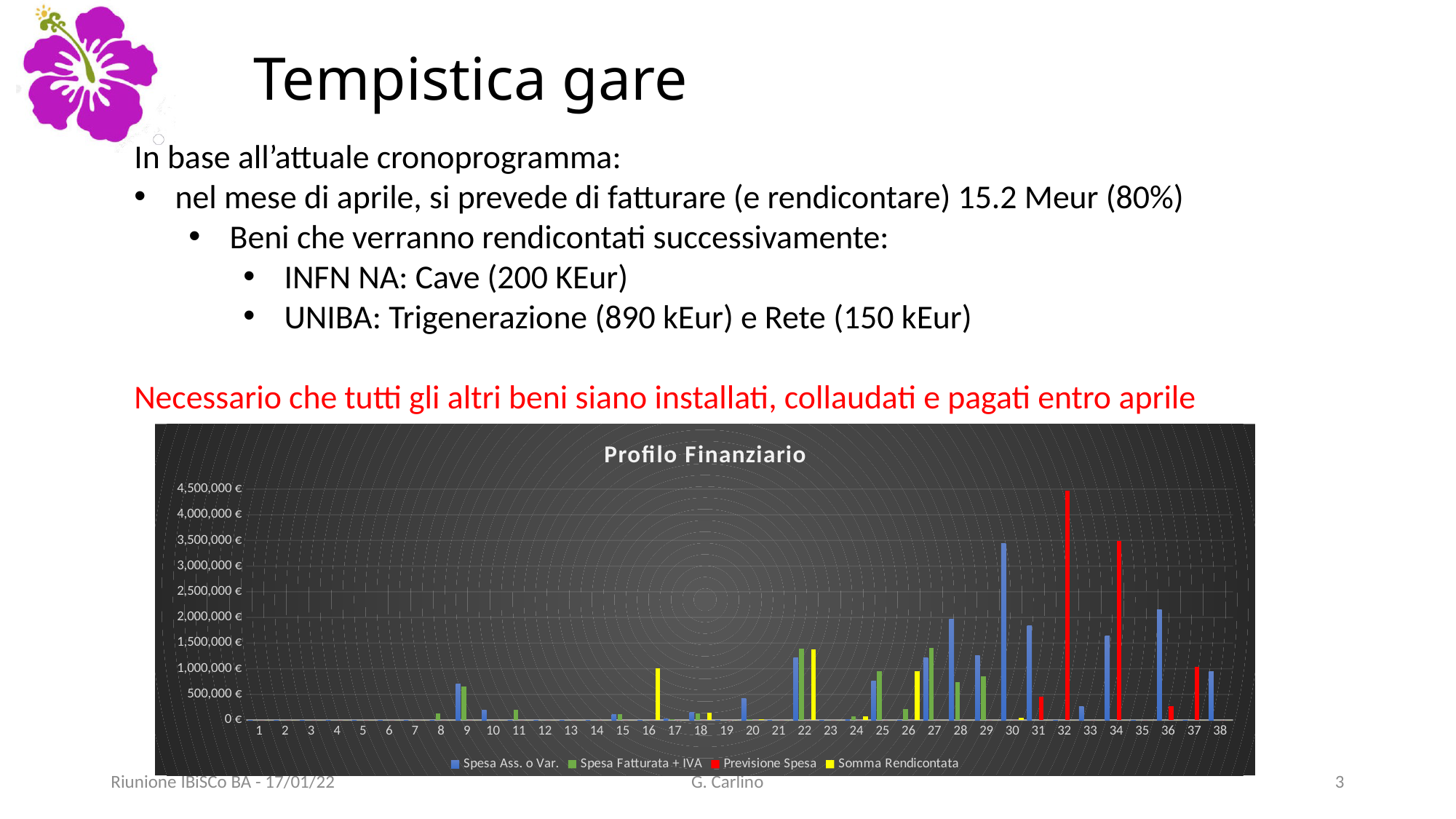
Which is larger: the Spesa Ass. o Var. value at category 30 or at category 36? category 30 How many series does the chart's legend list? 4 How many categories are shown along the x axis of the chart? 38 At which x-axis category does the Spesa Ass. o Var. series reach its highest value? 30 Is the Spesa Ass. o Var. value at category 20 greater or less than 500,000 €? less What is the title of the chart on the slide? Profilo Finanziario Is the Spesa Ass. o Var. value at category 30 greater or less than 3,000,000 €? greater Is the Previsione Spesa value at category 32 greater or less than 4,000,000 €? greater Which colour represents the Previsione Spesa series in the chart? red What kind of chart is shown on the slide? bar chart Which is larger: the Previsione Spesa value at category 32 or at category 34? category 32 At which x-axis category does the Previsione Spesa series reach its highest value? 32